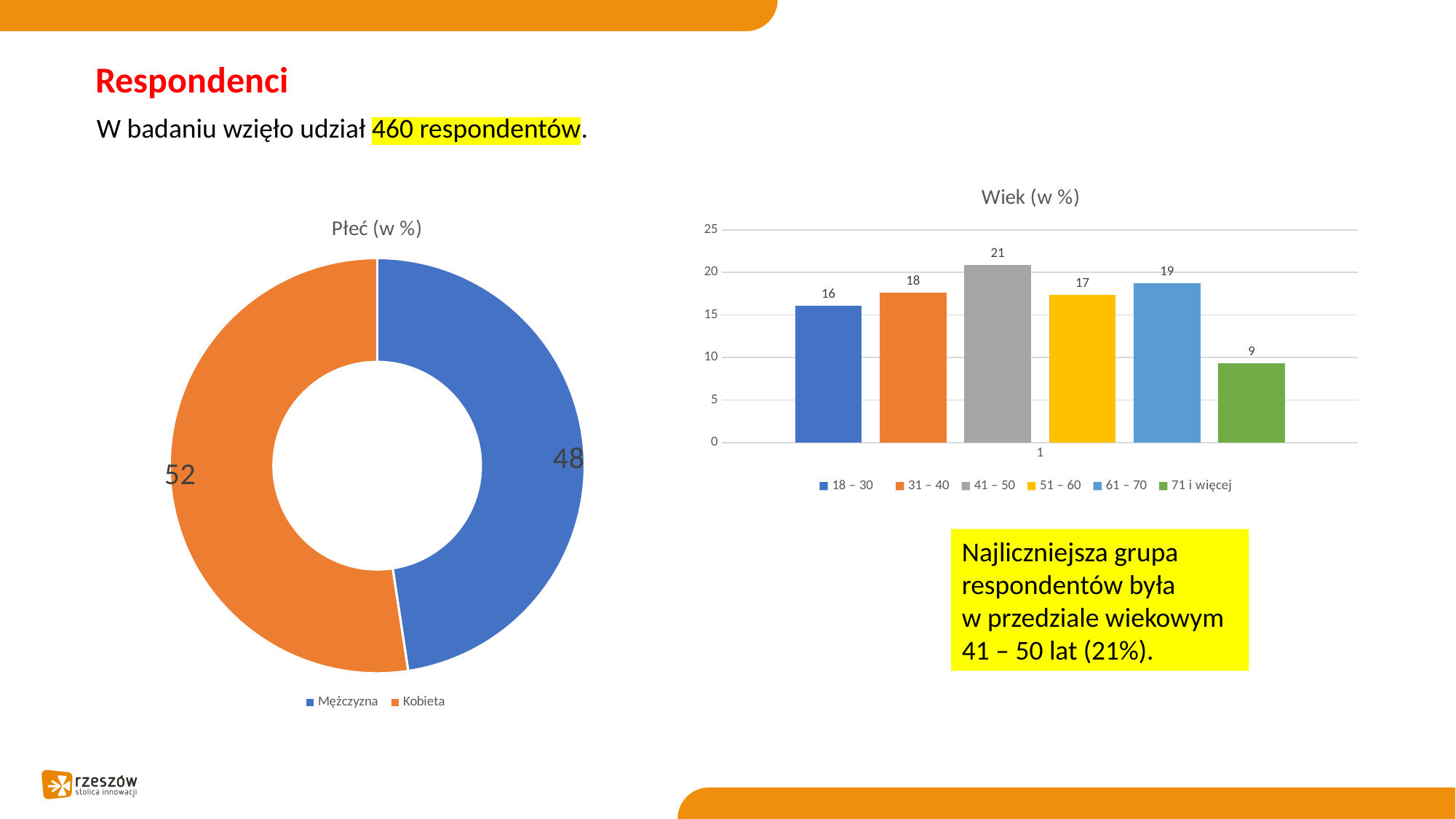
In the 'Płeć (w %)' chart, what is the difference between the Kobieta and Mężczyzna values? 4 In the 'Wiek (w %)' chart, what is the difference between the 61 – 70 and 18 – 30 values? 3 In the 'Wiek (w %)' chart, what is the value for the 41 – 50 age group? 21 In the 'Wiek (w %)' chart, which age group has the highest value? 41 – 50 In the 'Płeć (w %)' chart, what is the value for Mężczyzna? 48 In the 'Wiek (w %)' chart, which age group has the lowest value? 71 i więcej How many series does the legend of the 'Wiek (w %)' chart list? 6 What kind of chart is the 'Płeć (w %)' chart? Doughnut chart In the 'Wiek (w %)' chart, what is the value for the 71 i więcej age group? 9 In the 'Płeć (w %)' chart, which category has the larger share, Mężczyzna or Kobieta? Kobieta In the 'Płeć (w %)' chart, what is the value for Kobieta? 52 What kind of chart is the 'Wiek (w %)' chart? Bar chart